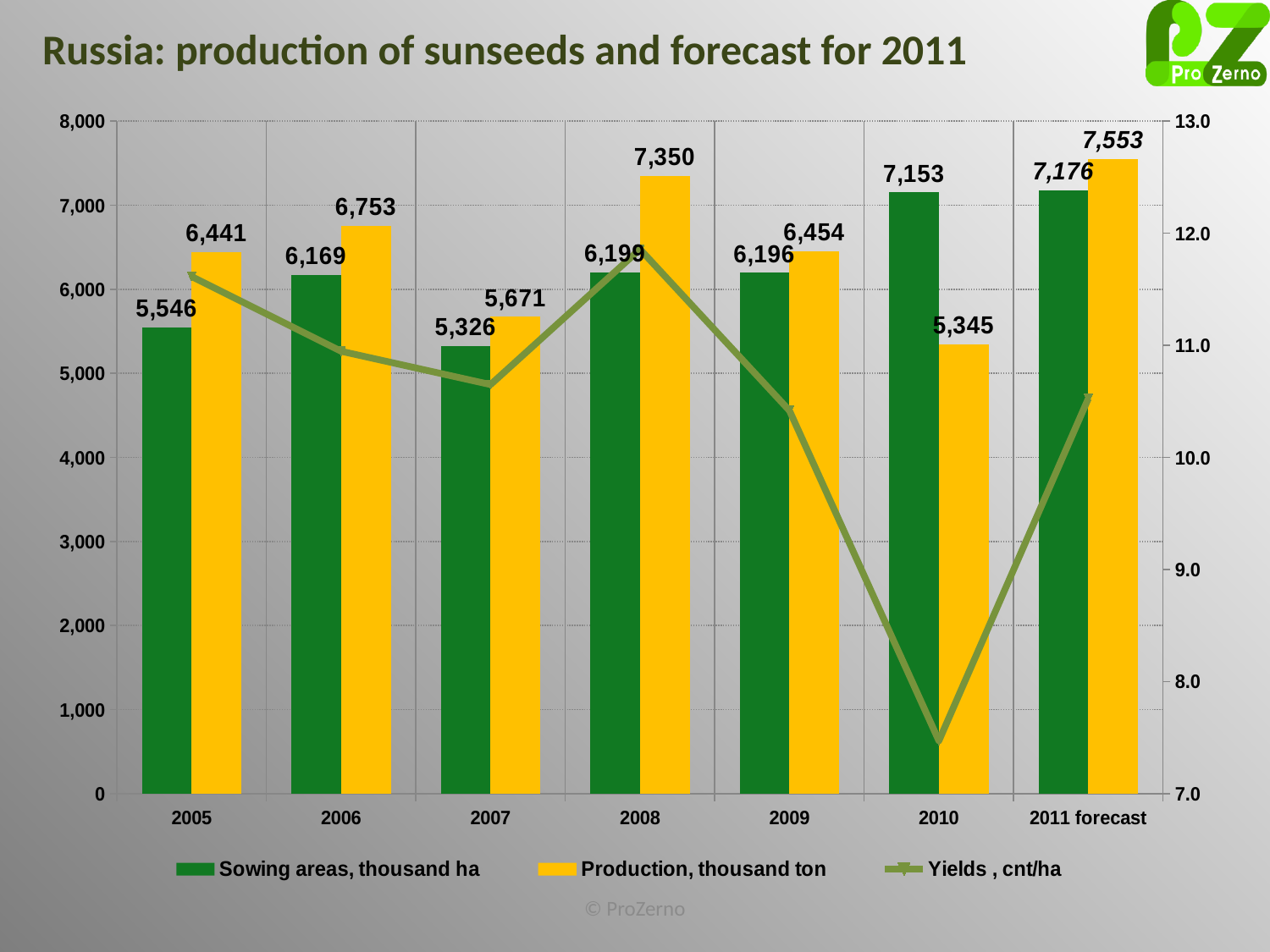
What is the difference between the production values for 2008 and 2010? 2,005 What is the sowing area value for the 2011 forecast? 7,176 Which year has the lowest production value? 2010 Which year has the highest production value? 2011 forecast How many series does the legend list? 3 Which year has the lowest sowing area value? 2007 How many years are shown on the x axis? 7 What is the sowing area value for 2007? 5,326 Is the yield value for 2008 greater or less than 11.0 cnt/ha? greater Which is larger in 2009: the sowing area or the production value? Production, 6,454 What is the production value for 2008? 7,350 Is the yield value for 2010 greater or less than 8.0 cnt/ha? less